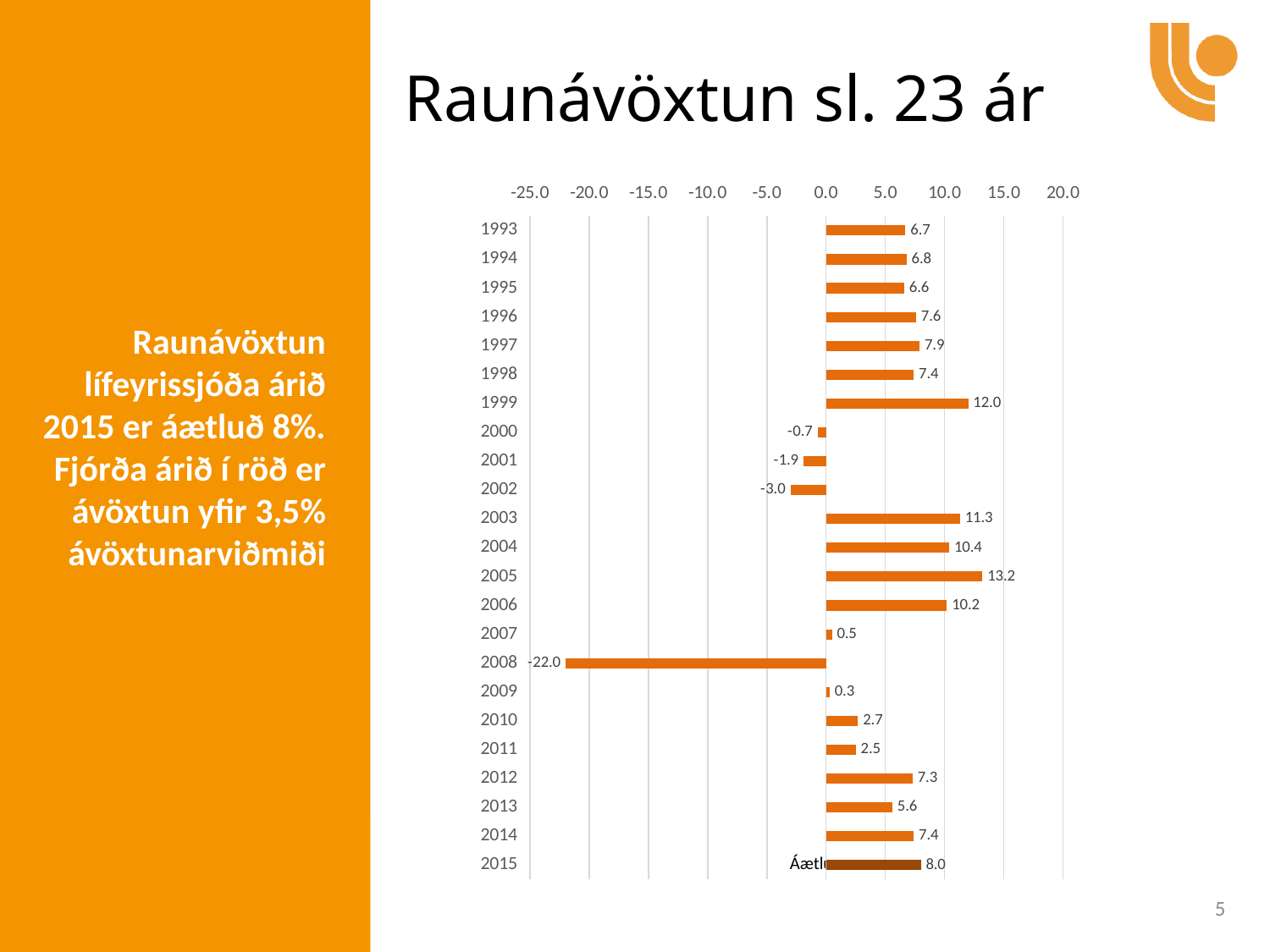
How many years are shown on the chart? 23 Is the value for 2008 greater or less than -20.0? less What kind of chart is shown on the slide? bar chart What is the difference between the values for 2005 and 2004? 2.8 Which year has the lowest value? 2008 What is the value for 2002? -3.0 What is the value for 2015? 8.0 What is the value for 2008? -22.0 What is the value for 1999? 12.0 Which year has the highest value? 2005 Which is larger, the value for 2003 or the value for 2006? 2003 What is the title of the slide? Raunávöxtun sl. 23 ár